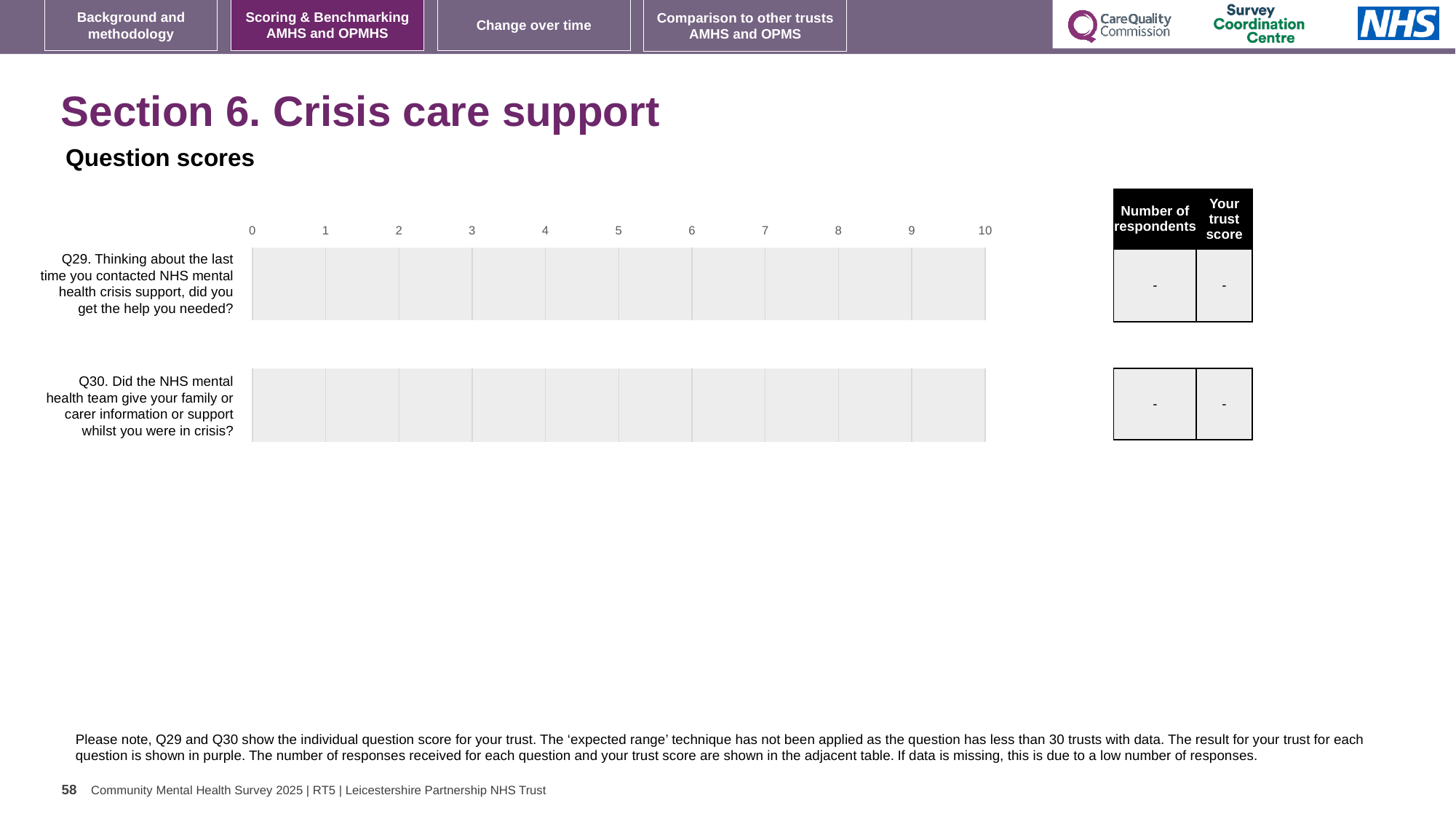
How many questions (categories) are listed on the chart? 2 Is a score bar plotted for Q30 on the chart? No What kind of chart is shown on the slide? bar chart What is the trust score shown in the table for Q30? - Is a score bar plotted for Q29 on the chart? No What is the lowest value shown on the chart's horizontal axis? 0 What is the highest value shown on the chart's horizontal axis? 10 What is the number of respondents shown in the table for Q29? -